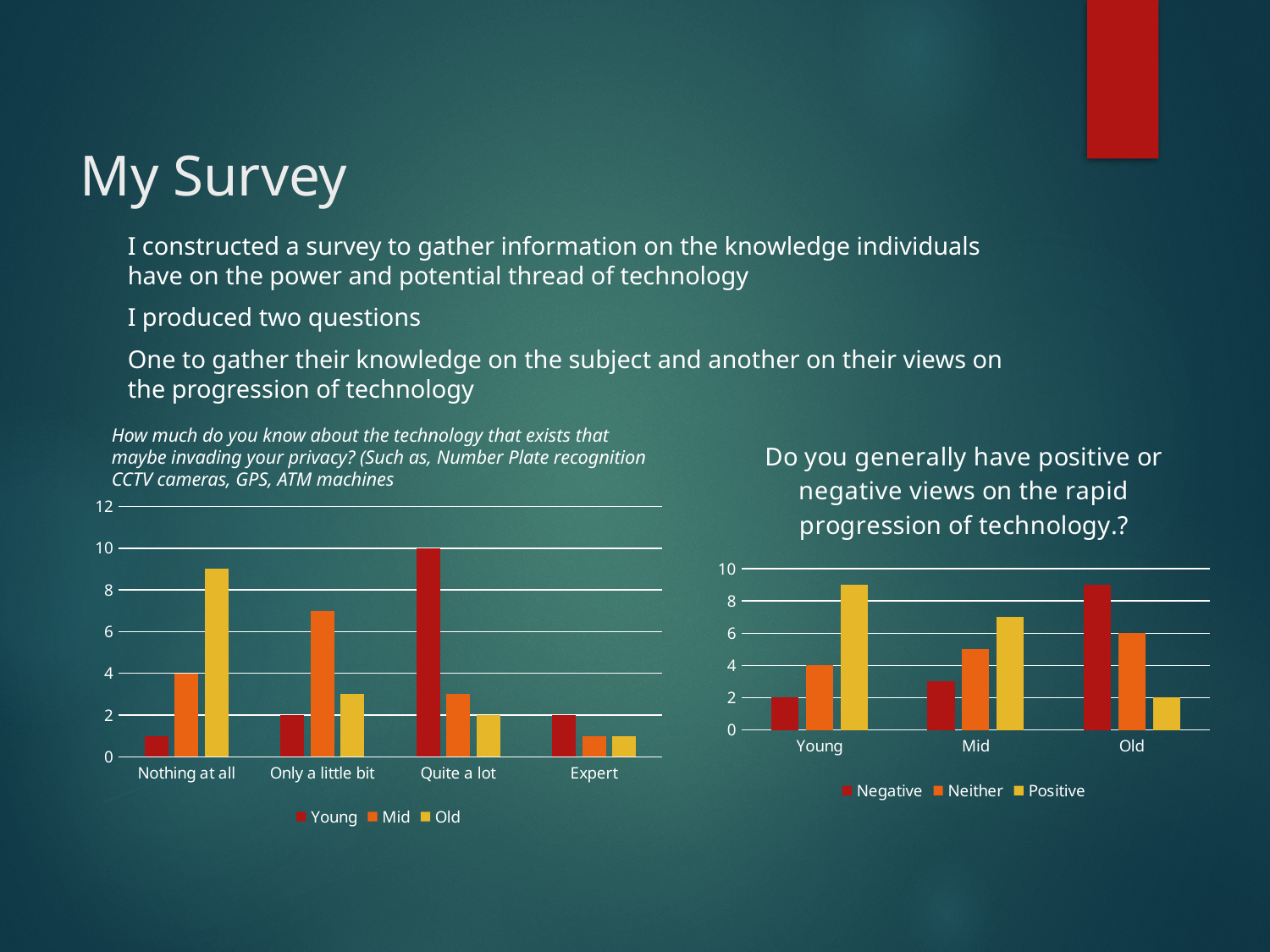
In the right chart, is the value for Positive in the Young category greater or less than 8? greater What type of chart is the right chart? Bar chart In the left chart, how many series does the legend list? 3 In the right chart, what is the value for Neither in the Old category? 6 In the left chart, what is the value for Young in the Quite a lot category? 10 In the right chart, what is the value for Negative in the Young category? 2 In the left chart, which is larger: Young in Quite a lot or Young in Expert? Young in Quite a lot In the left chart, which series has the highest value in the Only a little bit category? Mid In the right chart, which series has the highest value in the Old category? Negative In the left chart, is the value for Old in the Nothing at all category greater or less than 8? greater In the left chart, what is the value for Mid in the Nothing at all category? 4 In the left chart, how many categories are shown on the x axis? 4